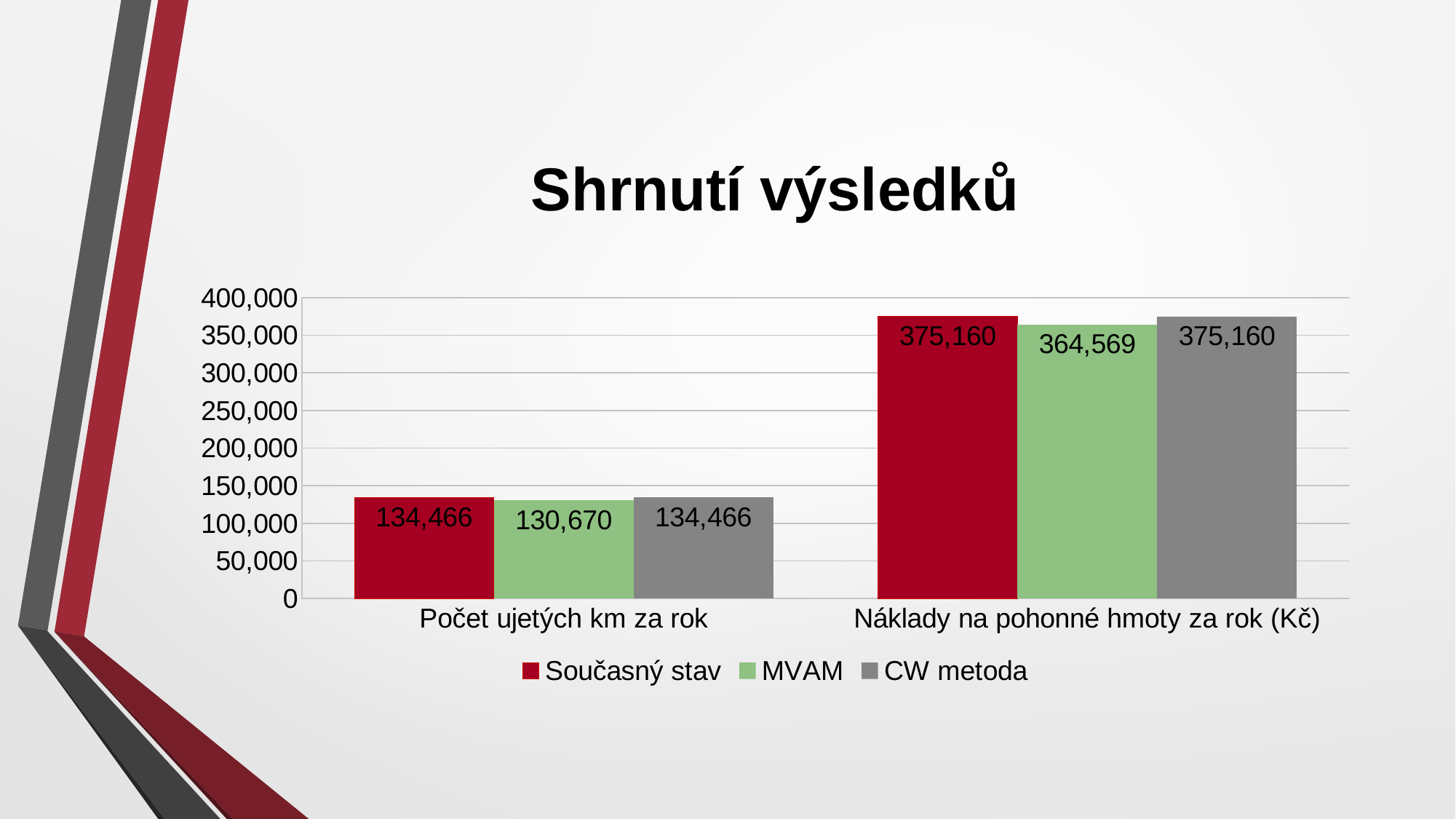
What is the value for MVAM in the category Počet ujetých km za rok? 130,670 Which series has the lowest value in the category Počet ujetých km za rok? MVAM Which series has the lowest value in the category Náklady na pohonné hmoty za rok (Kč)? MVAM What kind of chart is shown on the slide? Bar chart What is the value for CW metoda in the category Náklady na pohonné hmoty za rok (Kč)? 375,160 What is the value for MVAM in the category Náklady na pohonné hmoty za rok (Kč)? 364,569 What is the value for Současný stav in the category Počet ujetých km za rok? 134,466 Which is larger in the category Náklady na pohonné hmoty za rok (Kč): Současný stav or MVAM? Současný stav What is the difference between CW metoda and MVAM in the category Náklady na pohonné hmoty za rok (Kč)? 10,591 How many categories are shown on the x axis? 2 What is the difference between Současný stav and MVAM in the category Počet ujetých km za rok? 3,796 How many series does the legend list? 3